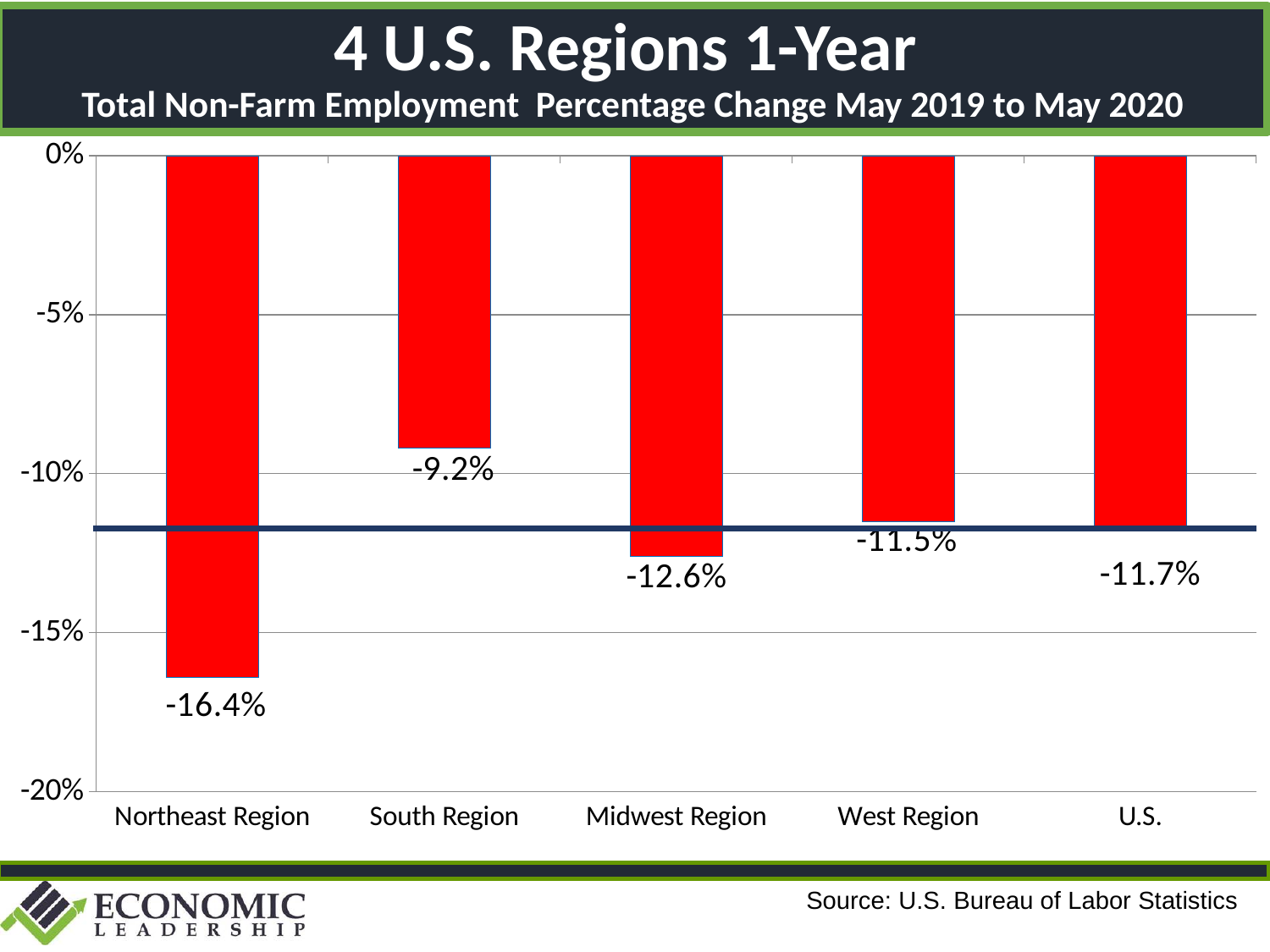
Which had a larger decline in non-farm employment, the Midwest Region or the West Region? Midwest Region What is the percentage change in total non-farm employment for the South Region? -9.2% Which category shows the smallest decline in non-farm employment? South Region What is the percentage change in total non-farm employment for the Northeast Region? -16.4% What is the percentage change in total non-farm employment for the Midwest Region? -12.6% Which category shows the largest decline in non-farm employment? Northeast Region What kind of chart is shown on the slide? Bar chart How many categories are shown on the x axis of the chart? 5 What is the source cited for the data on the slide? U.S. Bureau of Labor Statistics What is the percentage change in total non-farm employment for the U.S. overall? -11.7% What is the difference in percentage points between the Northeast Region and the South Region? 7.2 percentage points What is the percentage change in total non-farm employment for the West Region? -11.5%